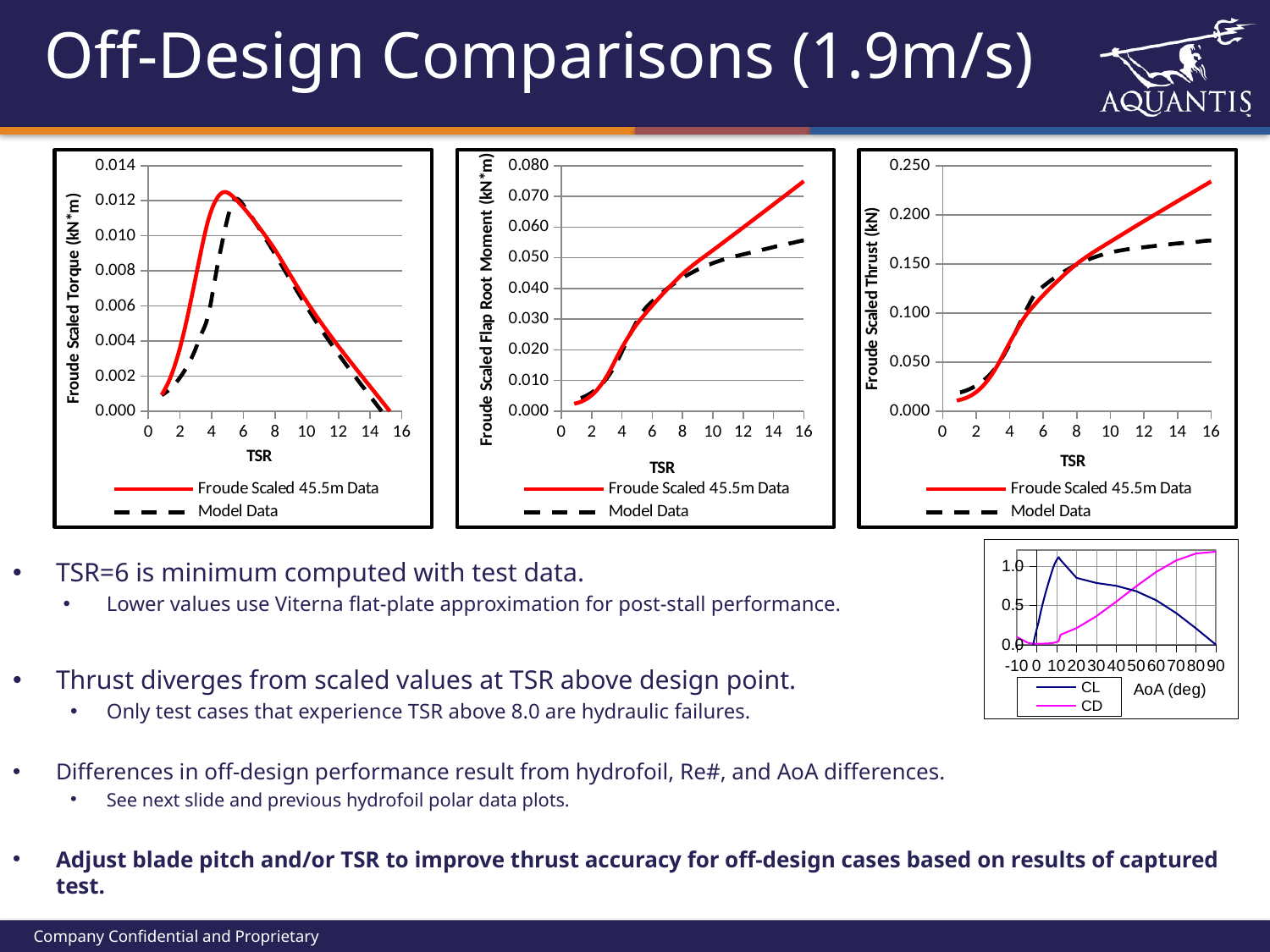
In the Froude Scaled Flap Root Moment chart, is the Froude Scaled 45.5m Data value at TSR 16 greater or less than 0.070? greater In the Froude Scaled Flap Root Moment chart, is the Model Data value at TSR 16 greater or less than 0.060? less What kind of chart is the Froude Scaled Thrust chart on the right? Line chart How many series does the legend of the Froude Scaled Torque chart list? 2 In the Froude Scaled Thrust chart, which series is higher at TSR 16, Froude Scaled 45.5m Data or Model Data? Froude Scaled 45.5m Data In the Froude Scaled Torque chart, is the peak of the Froude Scaled 45.5m Data line greater or less than 0.010? greater In the Froude Scaled Thrust chart, does the Froude Scaled 45.5m Data line rise or fall as TSR increases? Rise In the Froude Scaled Torque chart, which series is higher at TSR 2, Froude Scaled 45.5m Data or Model Data? Froude Scaled 45.5m Data What is the x-axis label on the Froude Scaled Thrust chart? TSR What are the two legend entries in the Froude Scaled Flap Root Moment chart? Froude Scaled 45.5m Data and Model Data